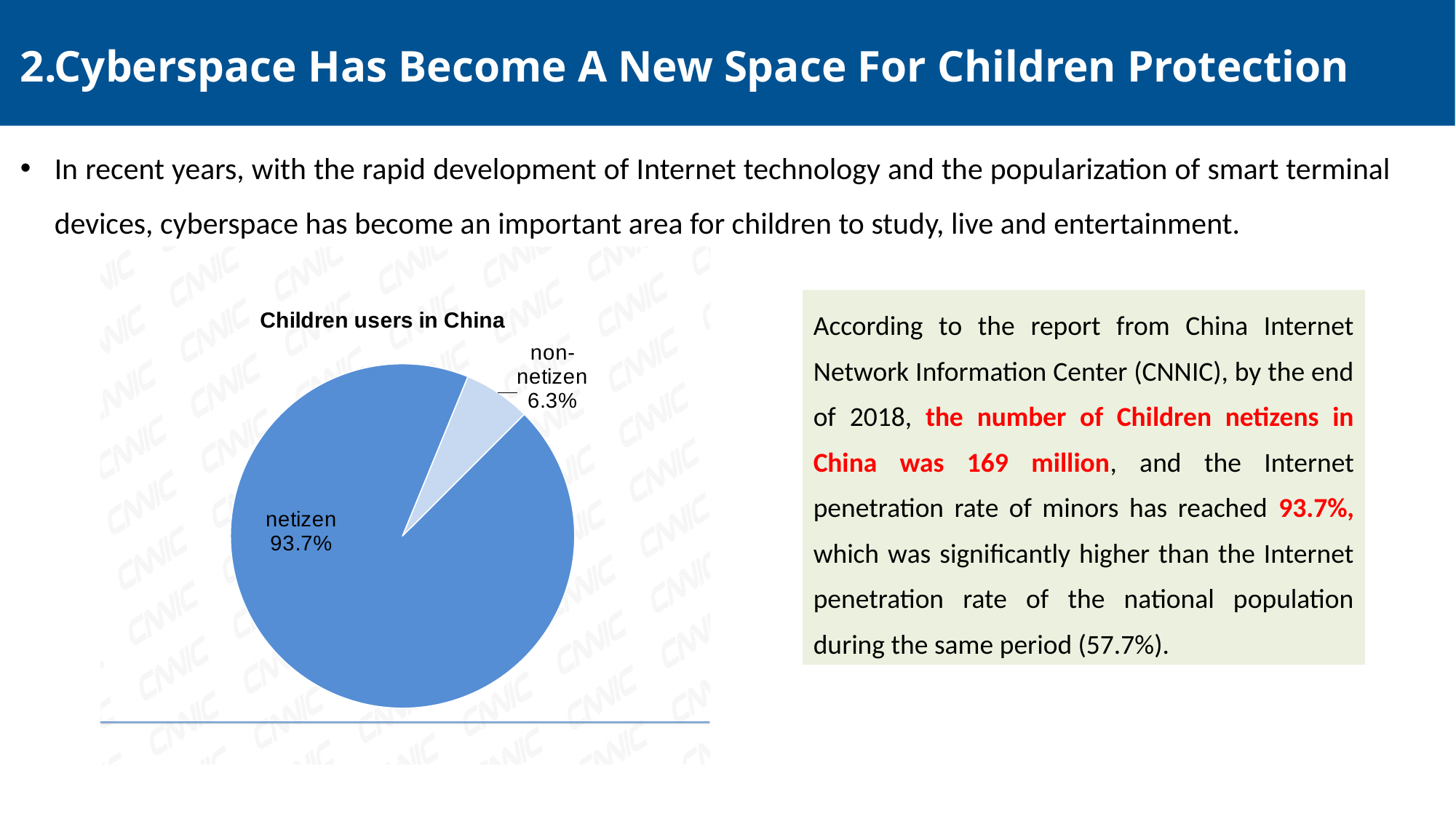
Which is larger, the netizen slice or the non-netizen slice? netizen How many slices does the pie chart have? 2 Which slice of the pie is the smallest? non-netizen What share of the pie is labelled non-netizen? 6.3% What share of the pie is labelled netizen? 93.7% What is the title of the chart? Children users in China Which slice of the pie is the largest? netizen What kind of chart is shown on the slide? pie chart What is the difference in percentage points between the netizen and non-netizen slices? 87.4 Which slice of the pie is shown in the lighter blue colour? non-netizen Is the non-netizen share greater or less than 10%? less Is the netizen share greater or less than 90%? greater